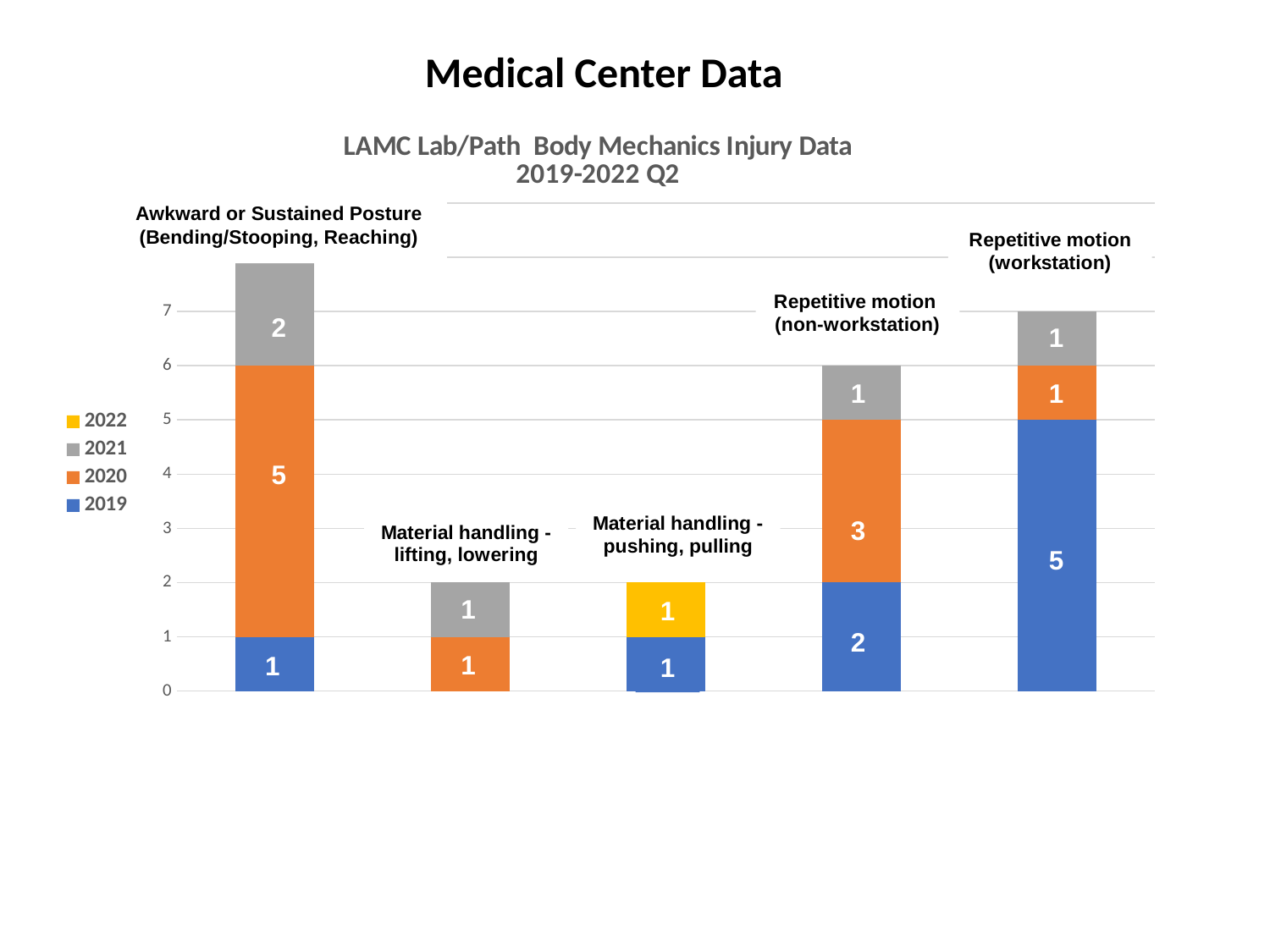
What is the 2021 value for Repetitive motion (non-workstation)? 1 What kind of chart is shown on the slide? Stacked bar chart What is the 2022 value for Material handling - pushing, pulling? 1 How many categories are shown on the x axis? 5 Which category has the highest stacked total? Awkward or Sustained Posture (Bending/Stooping, Reaching) What is the difference between the 2020 value for Awkward or Sustained Posture and the 2020 value for Repetitive motion (non-workstation)? 2 What is the 2020 value for Awkward or Sustained Posture (Bending/Stooping, Reaching)? 5 Which is larger: the 2019 value for Repetitive motion (workstation) or the 2019 value for Repetitive motion (non-workstation)? Repetitive motion (workstation) What is the 2019 value for Repetitive motion (workstation)? 5 What is the total of the stacked bar for Awkward or Sustained Posture (Bending/Stooping, Reaching)? 8 What is the total of the stacked bar for Repetitive motion (non-workstation)? 6 How many series does the legend list? 4